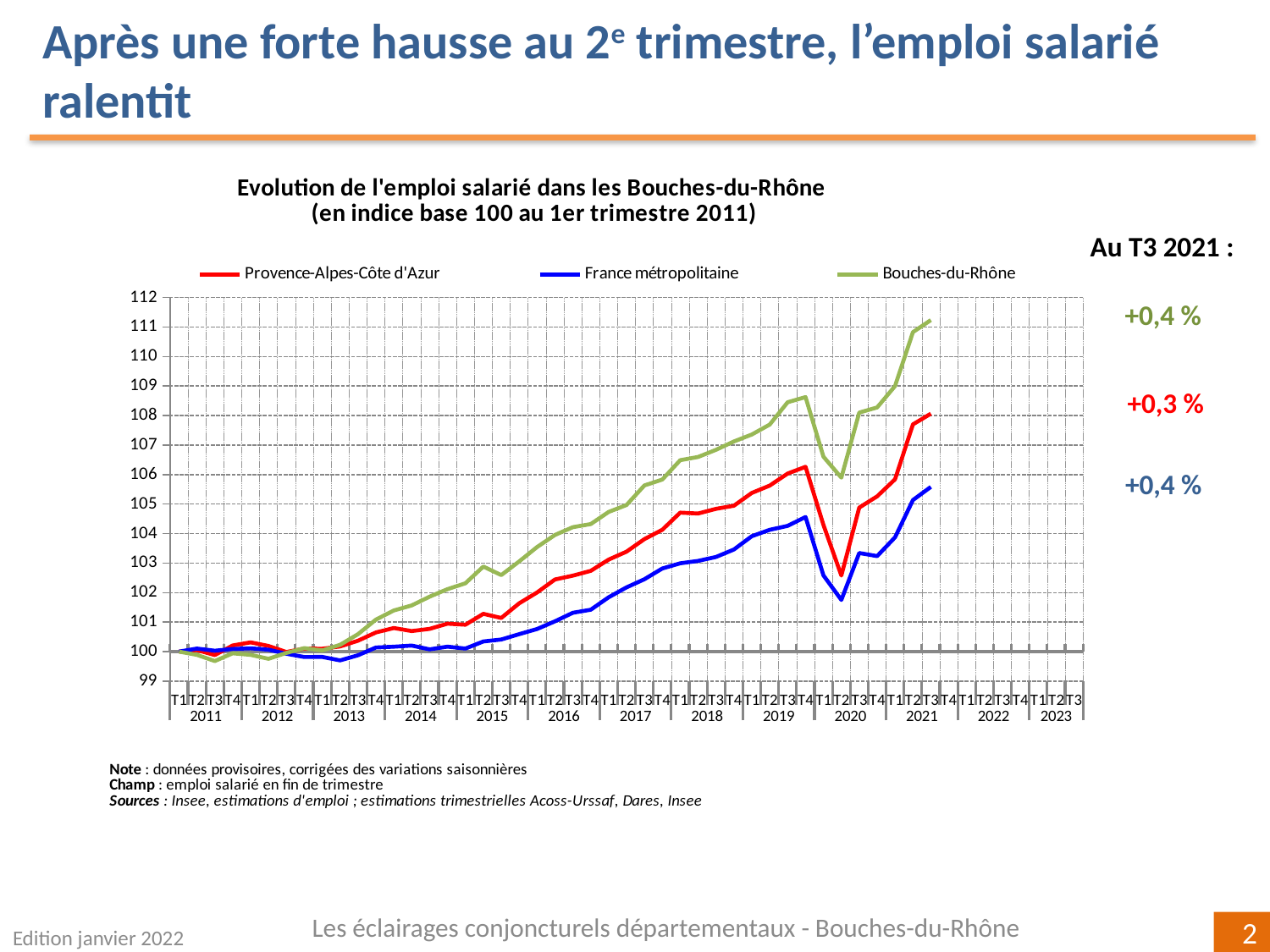
At T2 2020, which is higher: Bouches-du-Rhône or France métropolitaine? Bouches-du-Rhône Which three series are listed in the legend? Provence-Alpes-Côte d'Azur, France métropolitaine, Bouches-du-Rhône What change at T3 2021 is shown in red for Provence-Alpes-Côte d'Azur? +0,3 % How many series does the legend list? 3 Is the value for Provence-Alpes-Côte d'Azur at T3 2021 greater or less than 107? greater Which series has the lowest value at T3 2021? France métropolitaine Overall, do the index values rise or fall from 2011 to 2021? rise Is the value for France métropolitaine at T3 2021 greater or less than 106? less Is the value for France métropolitaine at T2 2020 greater or less than 103? less Which series has the highest value at T3 2021? Bouches-du-Rhône What kind of chart is shown on the slide? line chart